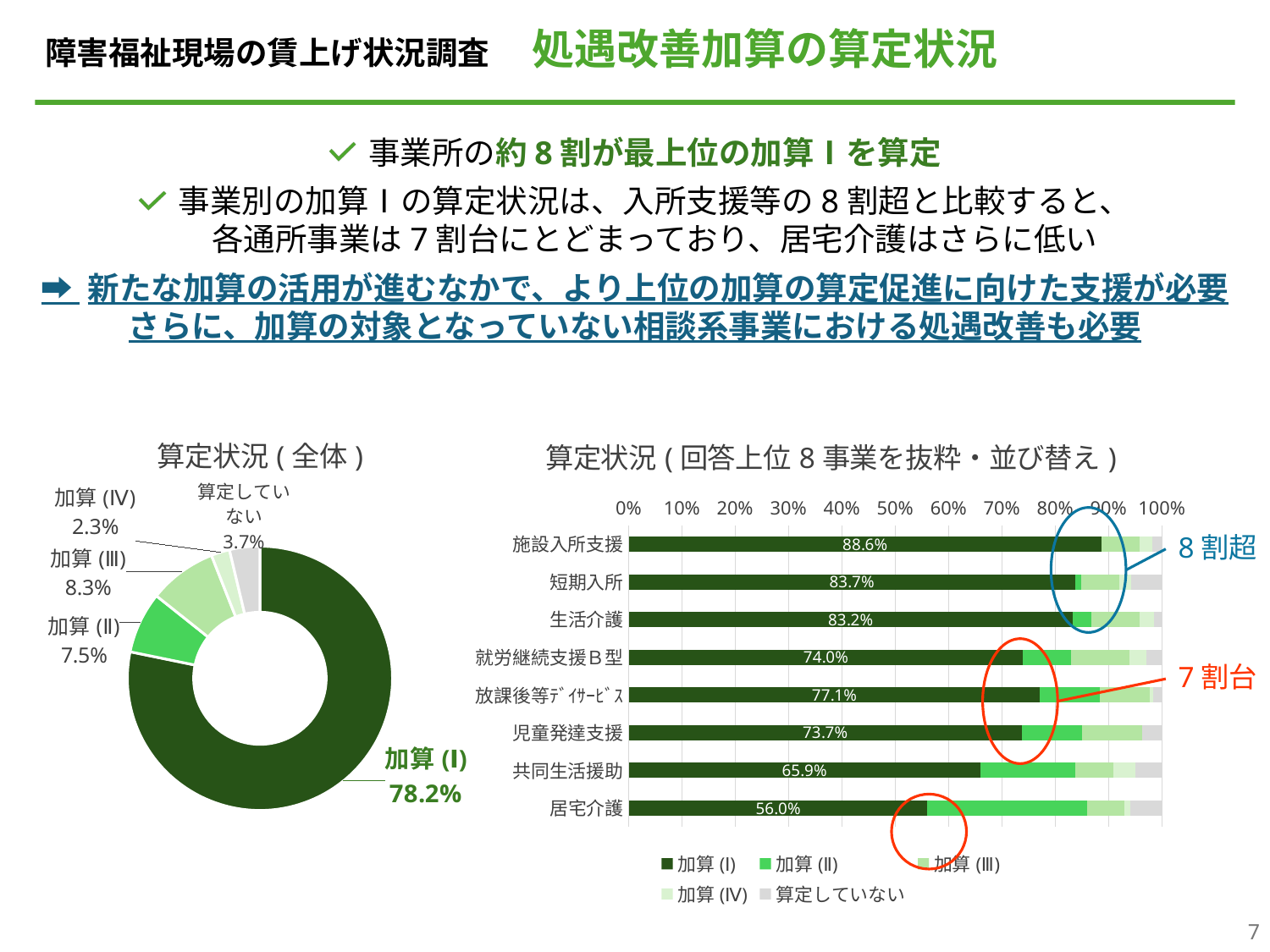
What kind of chart is the 算定状況(全体) chart? Donut (pie) chart In the 算定状況(全体) chart, which category has the smallest share? 加算(IV) In the 算定状況(回答上位8事業を抜粋・並び替え) chart, which has a higher 加算(I) value, 就労継続支援B型 or 放課後等デイサービス? 放課後等デイサービス How many series does the legend of the 算定状況(回答上位8事業を抜粋・並び替え) chart list? 5 How many categories are shown in the 算定状況(回答上位8事業を抜粋・並び替え) chart? 8 In the 算定状況(回答上位8事業を抜粋・並び替え) chart, which category has the lowest 加算(I) value? 居宅介護 In the 算定状況(全体) chart, what is the value for 算定していない? 3.7% In the 算定状況(回答上位8事業を抜粋・並び替え) chart, what is the 加算(I) value for 施設入所支援? 88.6% In the 算定状況(全体) chart, what is the difference between 加算(III) and 加算(II)? 0.8% In the 算定状況(全体) chart, what is the value for 加算(I)? 78.2% In the 算定状況(回答上位8事業を抜粋・並び替え) chart, what is the difference in 加算(I) between 施設入所支援 and 共同生活援助? 22.7% In the 算定状況(回答上位8事業を抜粋・並び替え) chart, what is the 加算(I) value for 居宅介護? 56.0%